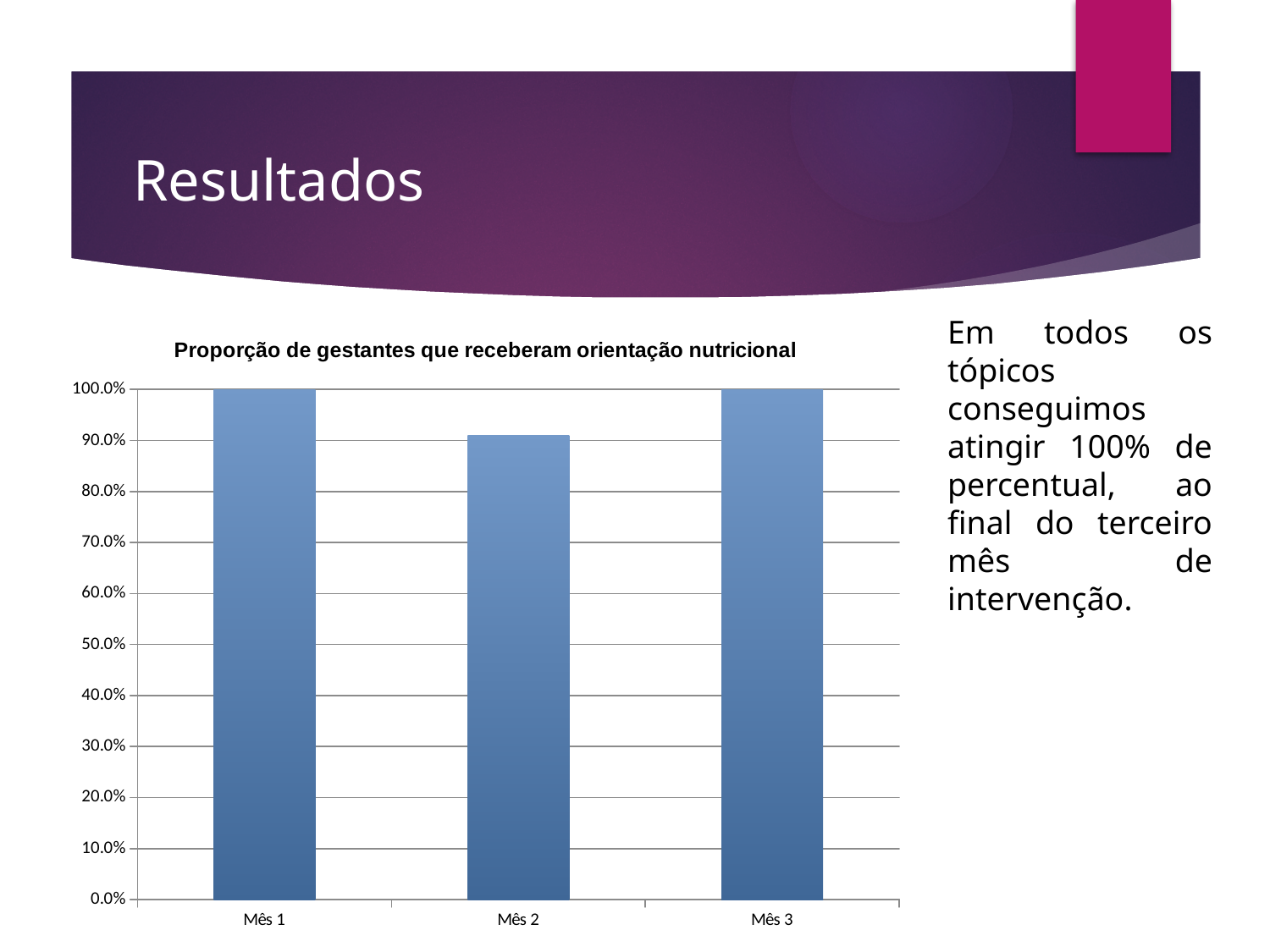
Which month has the lowest value? Mês 2 Which is larger, the value for Mês 1 or the value for Mês 2? Mês 1 What is the value for Mês 3? 100.0% How many months are shown on the x axis? 3 Is the value for Mês 2 greater or less than 80.0%? greater What is the title of the chart? Proporção de gestantes que receberam orientação nutricional Does the value fall or rise from Mês 2 to Mês 3? rise What is the highest value shown on the y axis? 100.0% What kind of chart is shown on the slide? bar chart Which is larger, the value for Mês 2 or the value for Mês 3? Mês 3 Is the value for Mês 2 greater or less than 100.0%? less What is the value for Mês 1? 100.0%